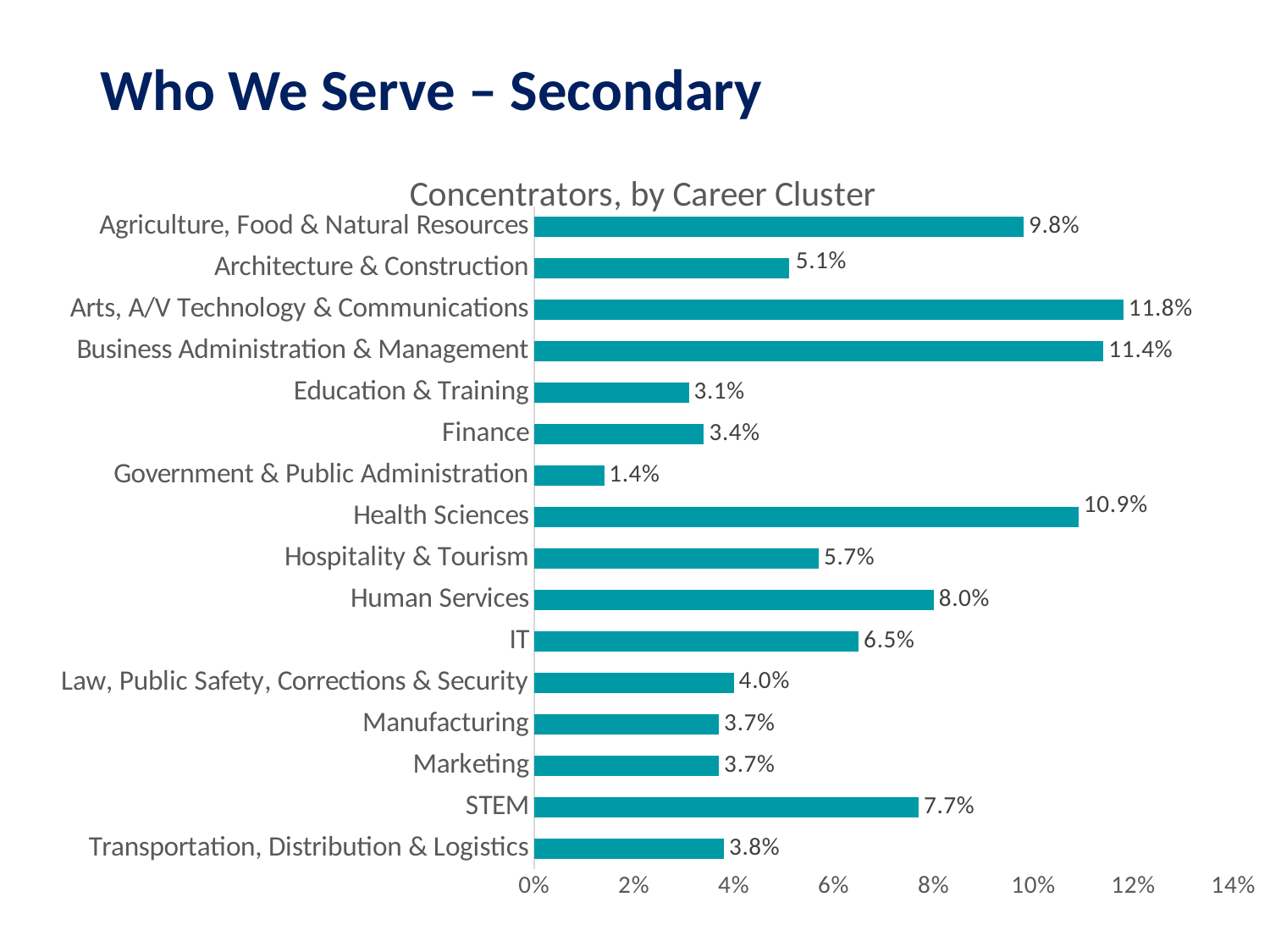
Which is larger, the value for Agriculture, Food & Natural Resources or the value for Health Sciences? Health Sciences What is the value for STEM? 7.7% What is the value for Government & Public Administration? 1.4% What is the value for Health Sciences? 10.9% Which career cluster has the highest share of concentrators? Arts, A/V Technology & Communications Is the value for Hospitality & Tourism greater or less than 4%? greater What is the title of the chart? Concentrators, by Career Cluster What kind of chart is shown on the slide? Bar chart What is the difference between the values for Human Services and IT? 1.5% What is the difference between the values for Arts, A/V Technology & Communications and Business Administration & Management? 0.4% How many career clusters are shown in the chart? 16 Which career cluster has the lowest share of concentrators? Government & Public Administration